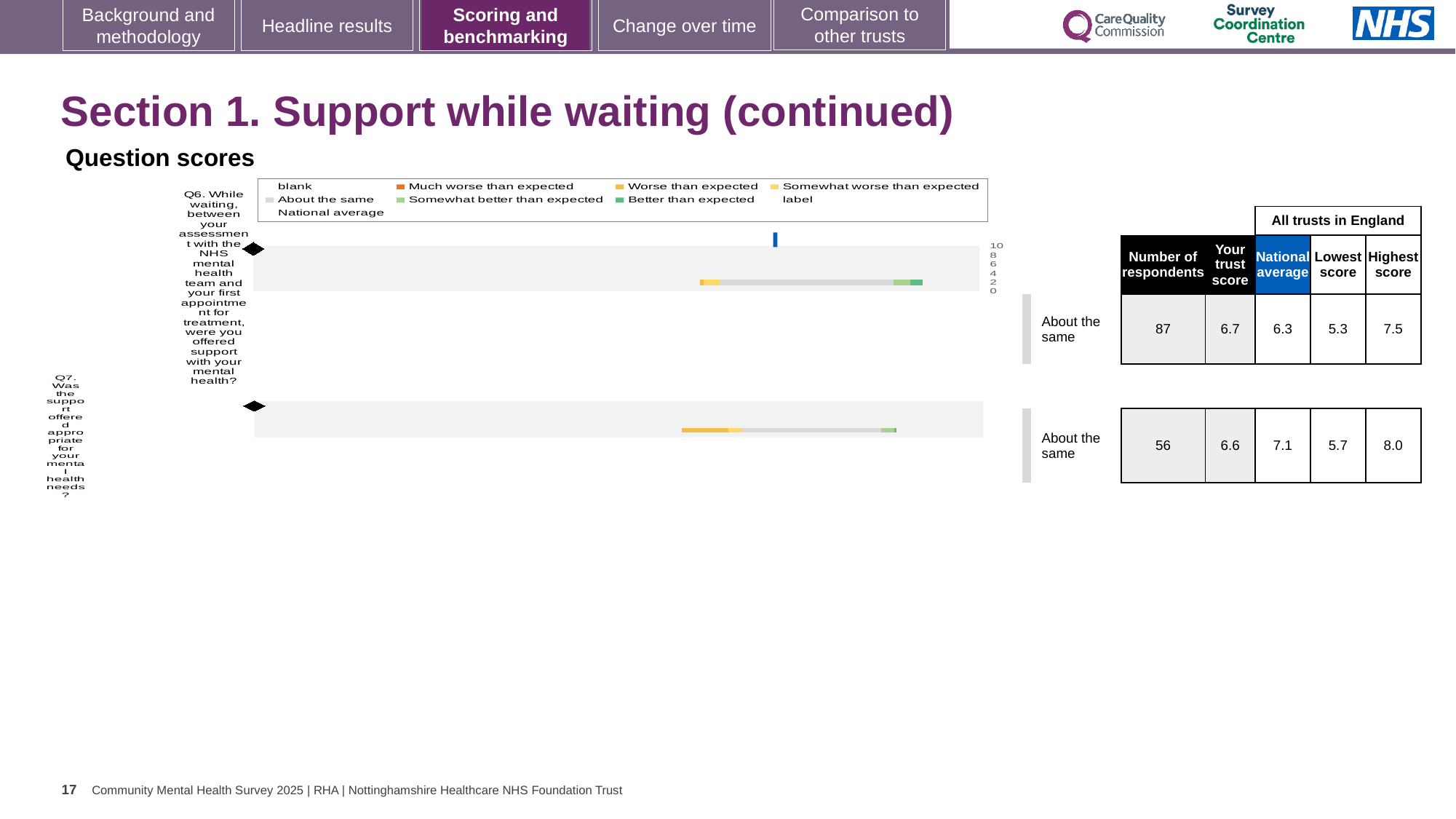
What benchmark category is shown for both Q6 and Q7 next to the chart? About the same Which question had more respondents, Q6 or Q7? Q6 What is the difference between the highest and lowest scores for Q6 across all trusts in England? 2.2 What is the national average score for Q7 (was the support offered appropriate for your mental health needs)? 7.1 What is the 'Your trust score' for Q6 (support with your mental health while waiting)? 6.7 How many respondents answered Q6? 87 For Q7, which is larger: the trust score or the national average? the national average What is the highest score among all trusts in England for Q7? 8.0 For Q6, which is larger: the trust score or the national average? the trust score What is the lowest score among all trusts in England for Q6? 5.3 How many questions (categories) are plotted in the question scores chart? 2 What kind of chart is used to show the question scores on this slide? bar chart